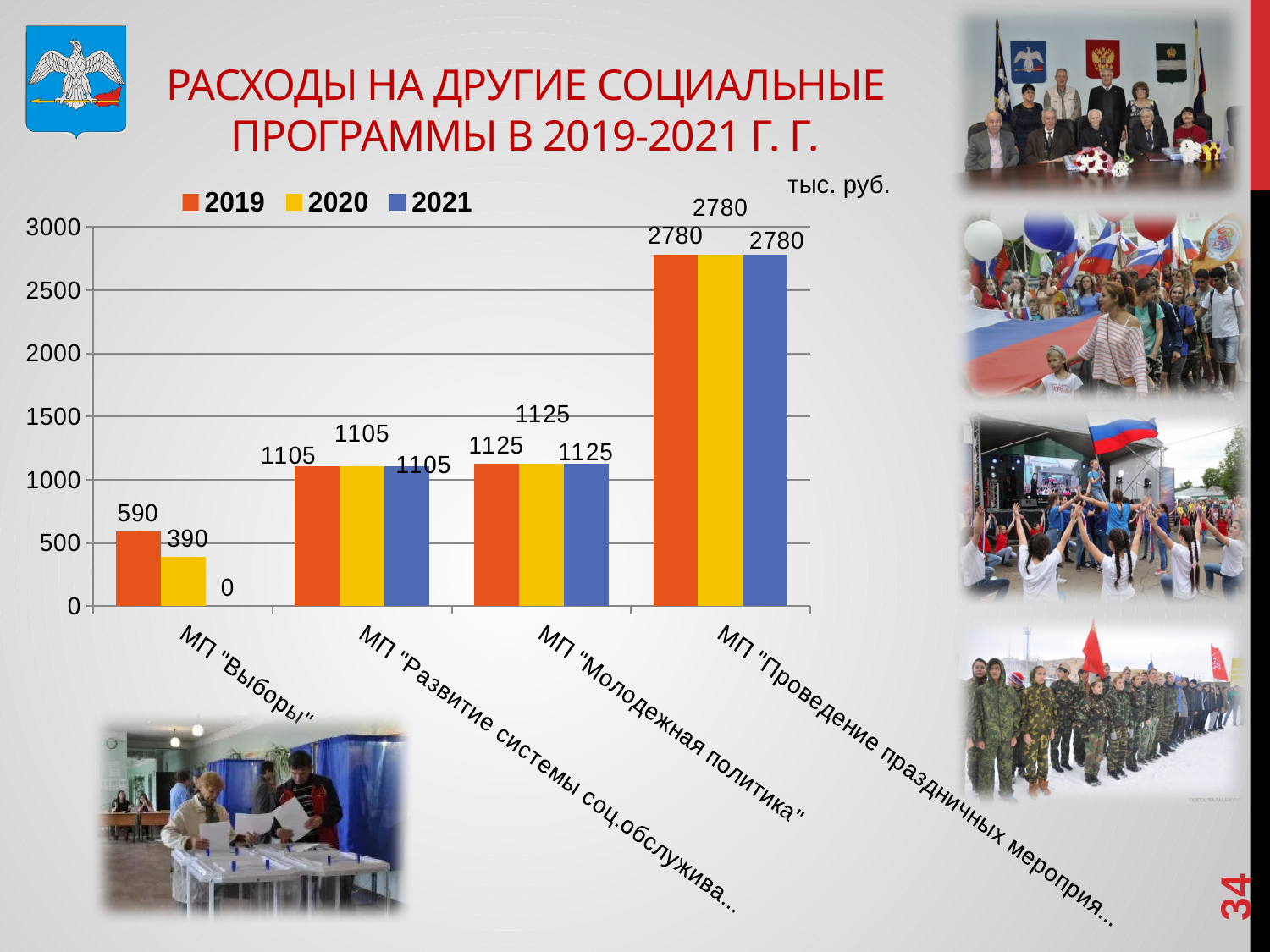
How many categories are shown on the x axis? 4 Which category has the highest value in 2020? МП "Проведение праздничных мероприя..." What is the value for МП "Выборы" in 2021? 0 What kind of chart is shown on the slide? Bar chart What is the value for МП "Молодежная политика" in 2021? 1125 What is the value for МП "Выборы" in 2020? 390 What is the value for МП "Выборы" in 2019? 590 How many series does the legend list? 3 Which category has the lowest value in 2021? МП "Выборы" What is the difference between the 2019 and 2020 values for МП "Выборы"? 200 What unit is indicated above the chart? тыс. руб. Which is larger: the 2019 value for МП "Молодежная политика" or the 2019 value for МП "Развитие системы соц.обслужива..."? МП "Молодежная политика"